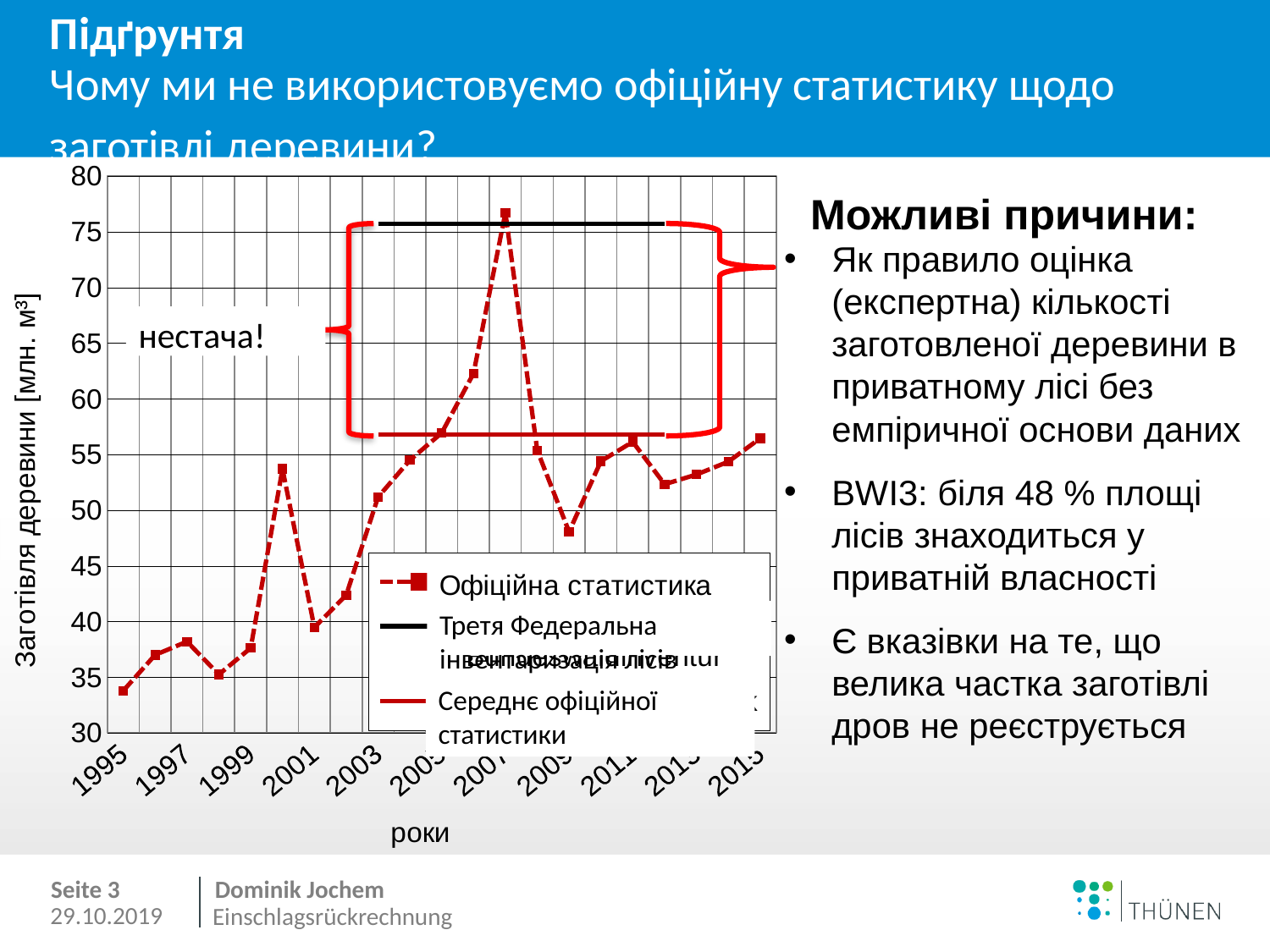
Is the 'Офіційна статистика' value for 2009 greater or less than 50? less Is the 'Офіційна статистика' value for 1995 greater or less than 35? less Which year has the larger 'Офіційна статистика' value, 2007 or 2009? 2007 How many series does the chart legend list? 3 What is the label of the vertical axis of the chart? Заготівля деревини [млн. м³] What kind of chart is shown on the slide? line chart Is the 'Офіційна статистика' value for 2007 greater or less than 70? greater Which year has the larger 'Офіційна статистика' value, 2000 or 2001? 2000 In which year does the 'Офіційна статистика' series reach its highest value? 2007 Does the 'Офіційна статистика' series rise or fall between 2007 and 2009? fall